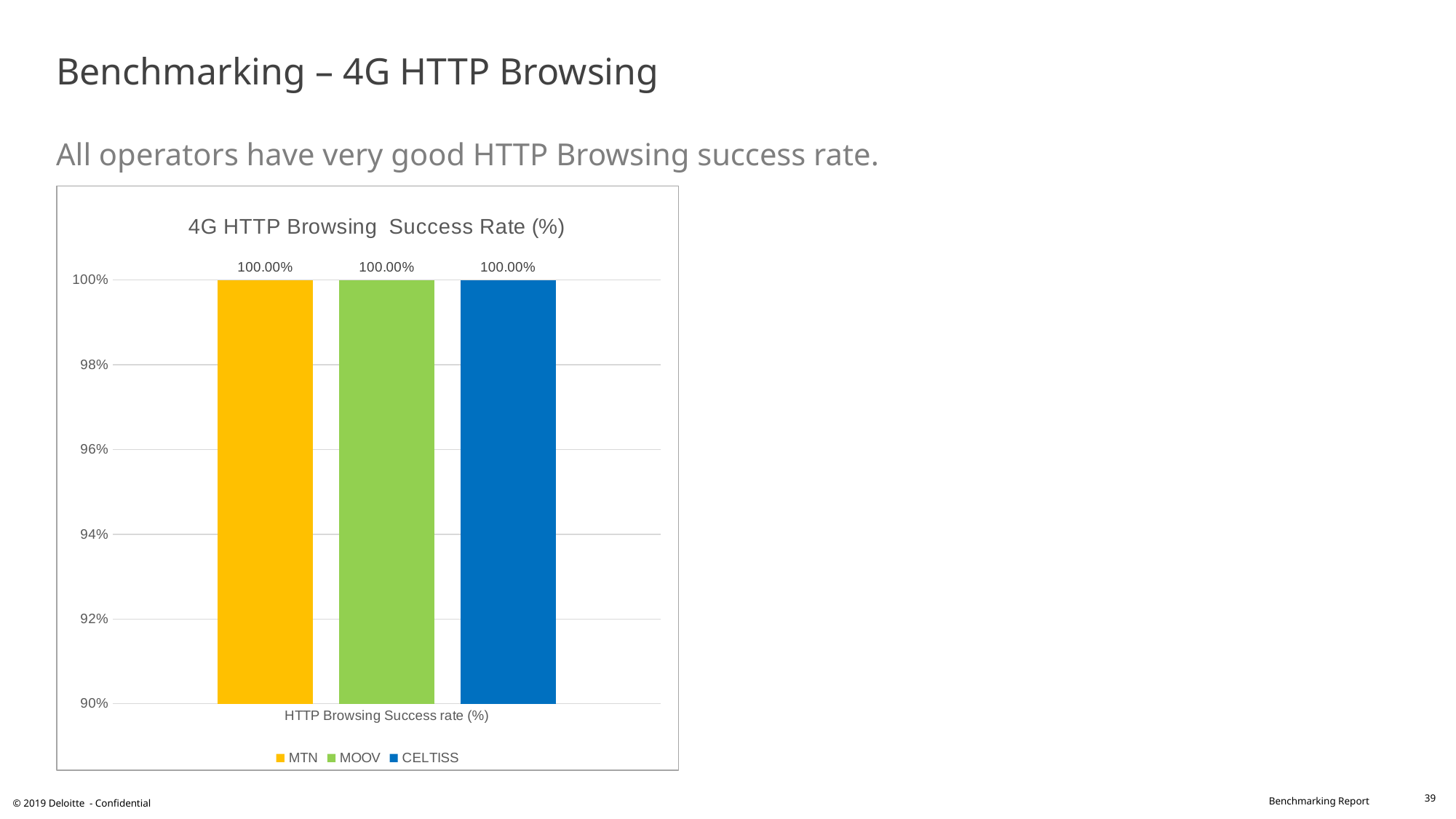
What is the difference between the MTN and CELTISS HTTP Browsing Success rates? 0.00% What is the HTTP Browsing Success rate for MOOV? 100.00% How many series does the legend list? 3 What is the HTTP Browsing Success rate for MTN? 100.00% What kind of chart is shown on the slide? Bar chart What is the title of the chart? 4G HTTP Browsing Success Rate (%) What is the lowest value shown on the vertical axis? 90% Which colour represents CELTISS in the chart? Blue What is the HTTP Browsing Success rate for CELTISS? 100.00% Is the value for MOOV greater or less than 98%? greater